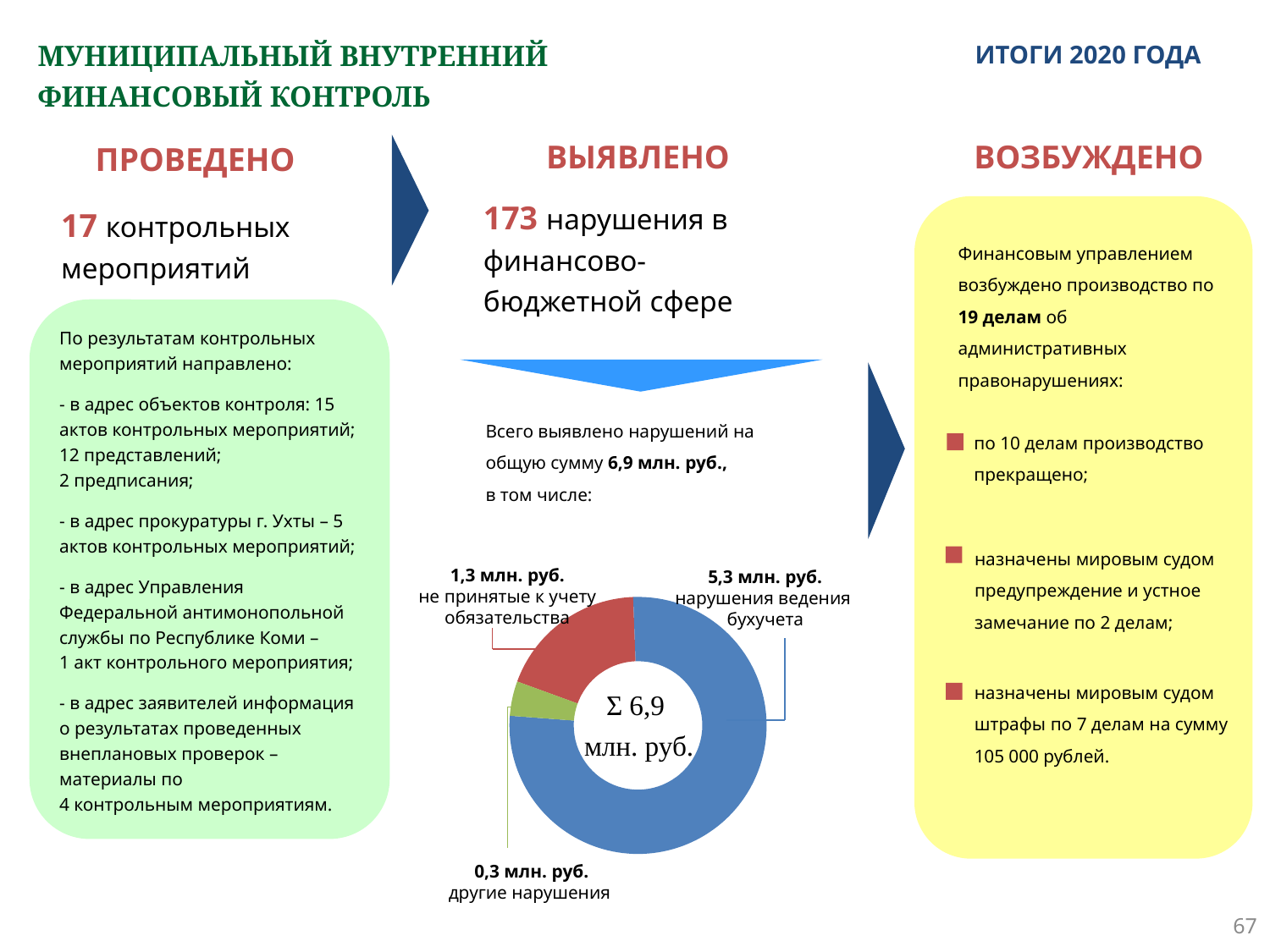
What is the value for "не принятые к учету обязательства" on the chart? 1,3 млн. руб. What is the value for "другие нарушения" on the chart? 0,3 млн. руб. How many categories (slices) does the chart have? 3 What is the value for "нарушения ведения бухучета" on the chart? 5,3 млн. руб. What colour is the slice for "нарушения ведения бухучета"? blue What is the difference between "нарушения ведения бухучета" and "не принятые к учету обязательства"? 4,0 млн. руб. Which is larger: "не принятые к учету обязательства" or "другие нарушения"? не принятые к учету обязательства What colour is the slice for "другие нарушения"? green What total is shown in the centre of the doughnut chart? Σ 6,9 млн. руб. Which category has the smallest slice in the chart? другие нарушения Which category has the largest slice in the chart? нарушения ведения бухучета What type of chart is shown on the slide? doughnut (pie) chart